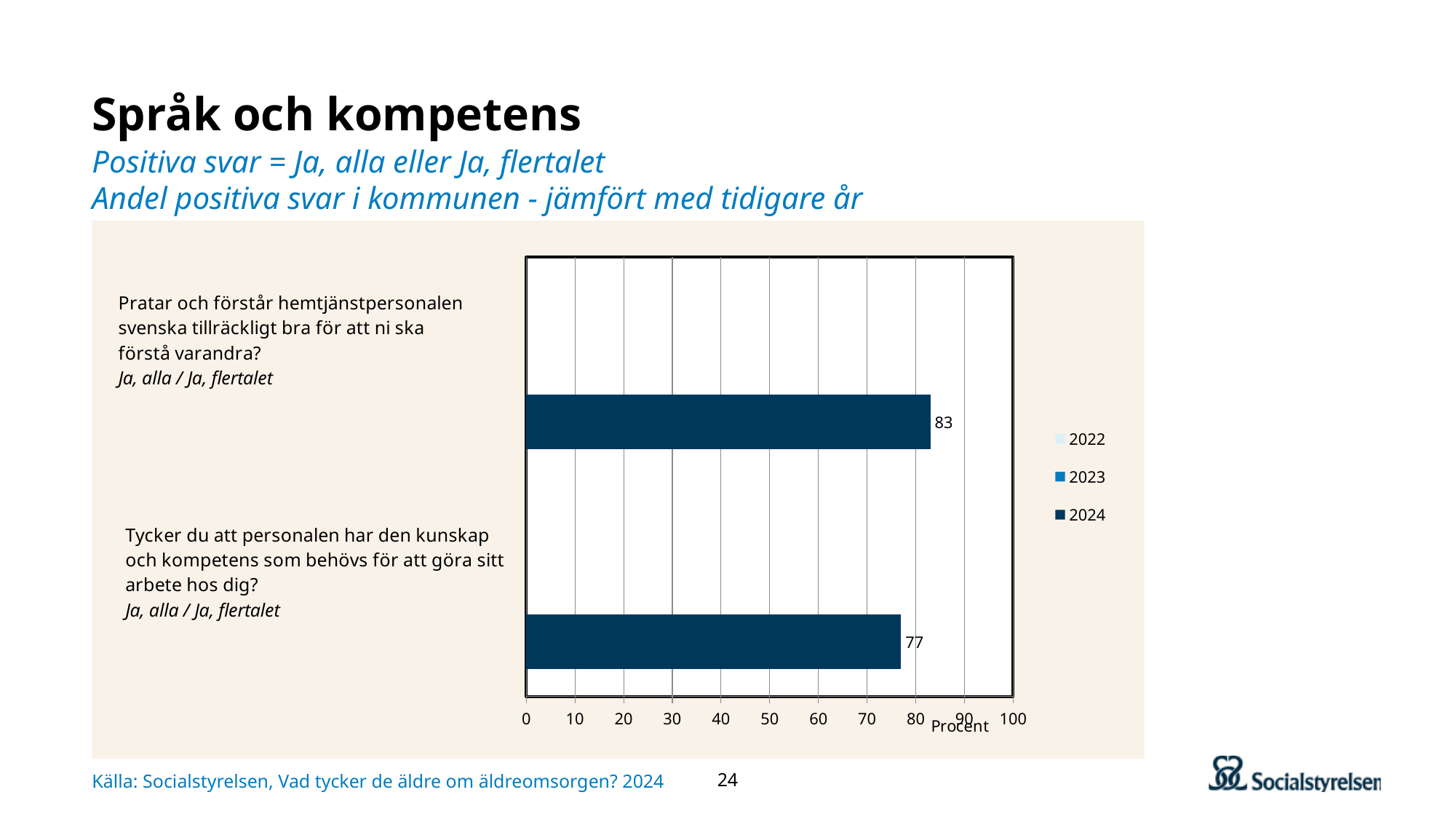
Which question has the lower 2024 value? Tycker du att personalen har den kunskap och kompetens som behövs för att göra sitt arbete hos dig? What is the 2024 value for "Pratar och förstår hemtjänstpersonalen svenska tillräckligt bra för att ni ska förstå varandra?"? 83 Is the 2024 value for the question about staff knowledge and competence larger or smaller than the 2024 value for the question about speaking Swedish? smaller What is the 2024 value for "Tycker du att personalen har den kunskap och kompetens som behövs för att göra sitt arbete hos dig?"? 77 What is the label on the horizontal axis of the chart? Procent How many questions (categories) are shown in the chart? 2 What kind of chart is shown on the slide? bar chart Which question has the higher 2024 value? Pratar och förstår hemtjänstpersonalen svenska tillräckligt bra för att ni ska förstå varandra? Is the 2024 value for the question about speaking Swedish greater or less than 80? greater How many series does the legend list? 3 Is the 2024 value for the question about staff knowledge and competence greater or less than 80? less What is the difference between the two 2024 values shown in the chart? 6